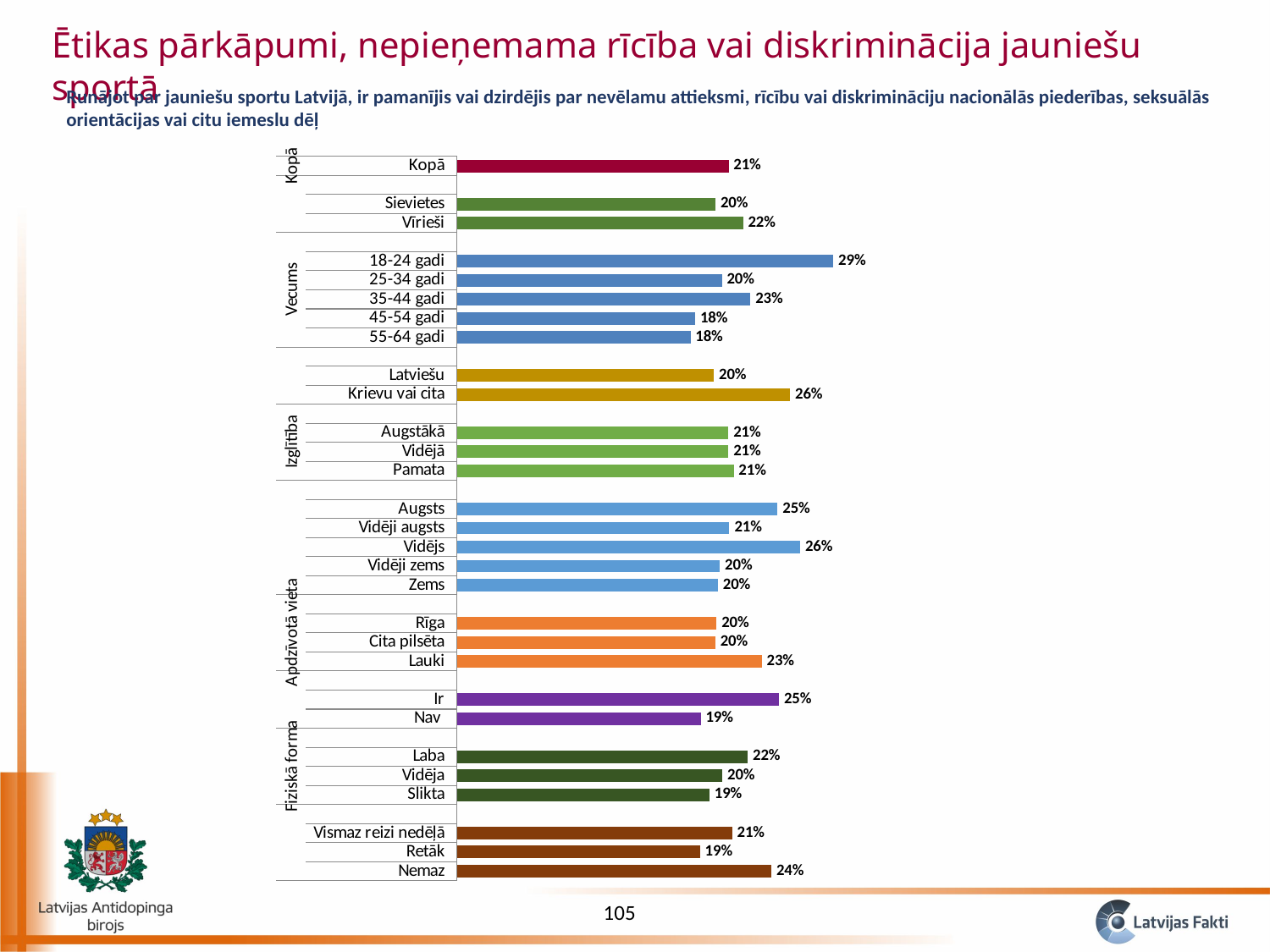
How many bars are plotted in the chart? 29 What is the value for "Nemaz"? 24% What kind of chart is shown on the slide? bar chart What is the value for "Krievu vai cita"? 26% What is the value for "18-24 gadi"? 29% What is the value for "Kopā"? 21% What is the difference between the values for "Krievu vai cita" and "Latviešu"? 6 percentage points Within the "Vecums" group, which age category has the highest value? 18-24 gadi Which has a larger value, "Lauki" or "Rīga"? Lauki Which has a larger value, "Vīrieši" or "Sievietes"? Vīrieši Which category has the highest value in the chart? 18-24 gadi What is the difference between the values for "Ir" and "Nav"? 6 percentage points